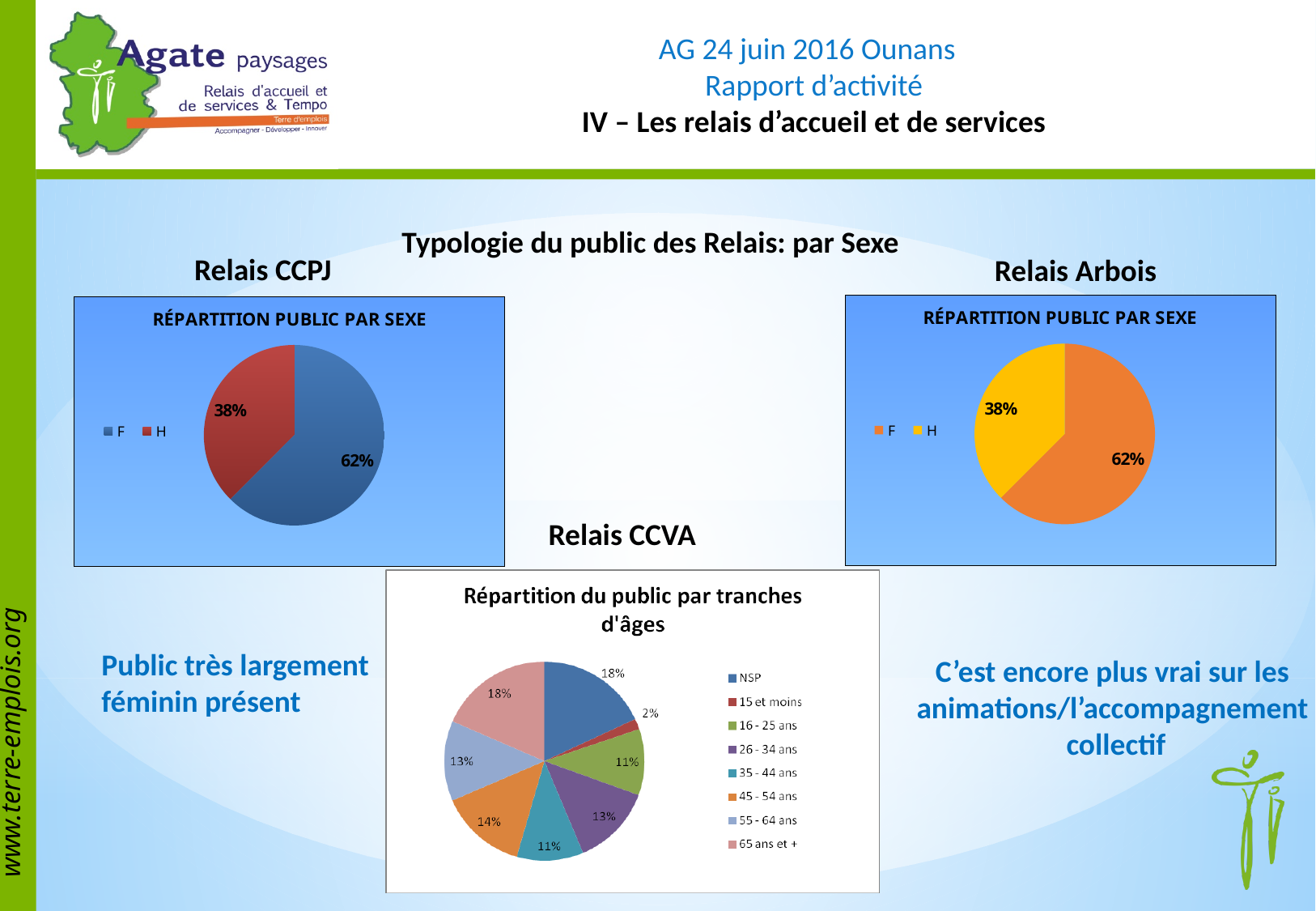
What is the title of the Relais Arbois chart? RÉPARTITION PUBLIC PAR SEXE In the Relais Arbois chart, which category has the larger share, F or H? F In the Relais CCVA chart, which is larger, the share for 26 - 34 ans or the share for 35 - 44 ans? 26 - 34 ans In the Relais CCPJ chart, what percentage of the public is F? 62% In the Relais CCVA chart, what is the share for 15 et moins? 2% How many categories does the legend of the Relais CCVA chart list? 8 In the Relais CCPJ chart, what is the difference between the F and H shares? 24% In the Relais CCVA chart, which age group has the smallest share? 15 et moins In the Relais Arbois chart, what percentage of the public is F? 62% What kind of chart is used for the Relais CCVA 'Répartition du public par tranches d'âges'? Pie chart In the Relais CCVA chart, what is the share for 45 - 54 ans? 14% In the Relais CCPJ chart, what percentage of the public is H? 38%